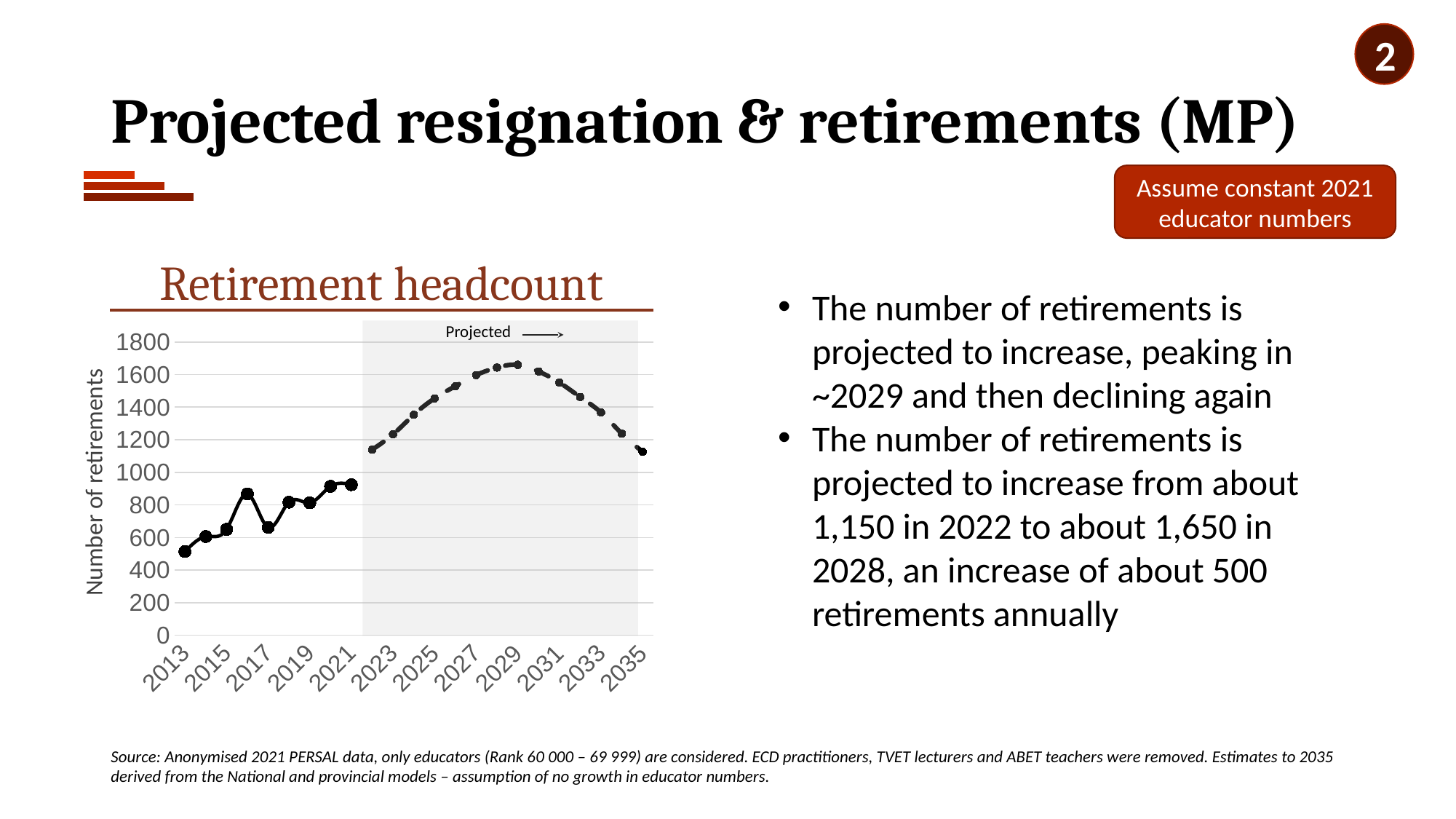
In the 'Retirement headcount' chart, is the value for 2035 greater or less than 1000? greater What kind of chart is the 'Retirement headcount' chart? line chart In the 'Retirement headcount' chart, which is larger, the value for 2016 or the value for 2017? 2016 What is the label on the vertical axis of the 'Retirement headcount' chart? Number of retirements In the 'Retirement headcount' chart, is the value for 2016 greater or less than 800? greater In the 'Retirement headcount' chart, is the value for 2029 greater or less than 1600? greater In the 'Retirement headcount' chart, do the values generally rise or fall from 2029 to 2035? fall What is the title of the chart on the slide? Retirement headcount In the 'Retirement headcount' chart, which year has the lowest number of retirements? 2013 In the 'Retirement headcount' chart, do the values generally rise or fall from 2013 to 2021? rise